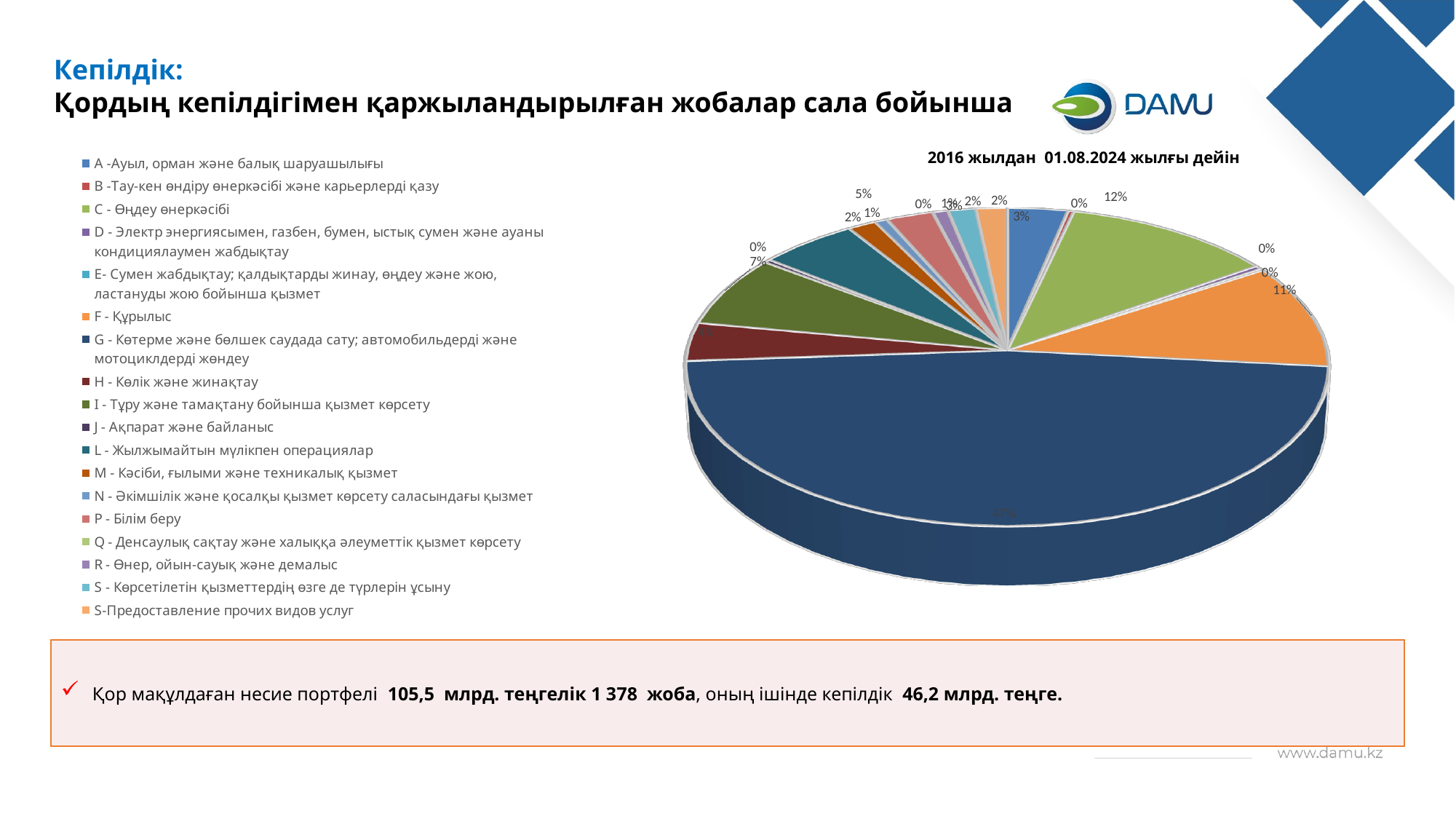
What colour is the largest slice of the pie? dark blue What share of the pie does category A - Ауыл, орман және балық шаруашылығы have? 3% Which category has the largest slice of the pie? G - Көтерме және бөлшек саудада сату; автомобильдерді және мотоциклдерді жөндеу What share of the pie does category F - Құрылыс have? 11% Which has a larger share: category C - Өңдеу өнеркәсібі or category A - Ауыл, орман және балық шаруашылығы? C - Өңдеу өнеркәсібі What period does the chart cover, according to the label above it? 2016 жылдан 01.08.2024 жылғы дейін What kind of chart is shown on the slide? pie chart How many categories does the legend of the pie chart list? 18 What is the difference in percentage points between category C - Өңдеу өнеркәсібі and category F - Құрылыс? 1% What share of the pie does category I - Тұру және тамақтану бойынша қызмет көрсету have? 7% What is the difference in percentage points between category C - Өңдеу өнеркәсібі and category A - Ауыл, орман және балық шаруашылығы? 9% What share of the pie does category C - Өңдеу өнеркәсібі have? 12%